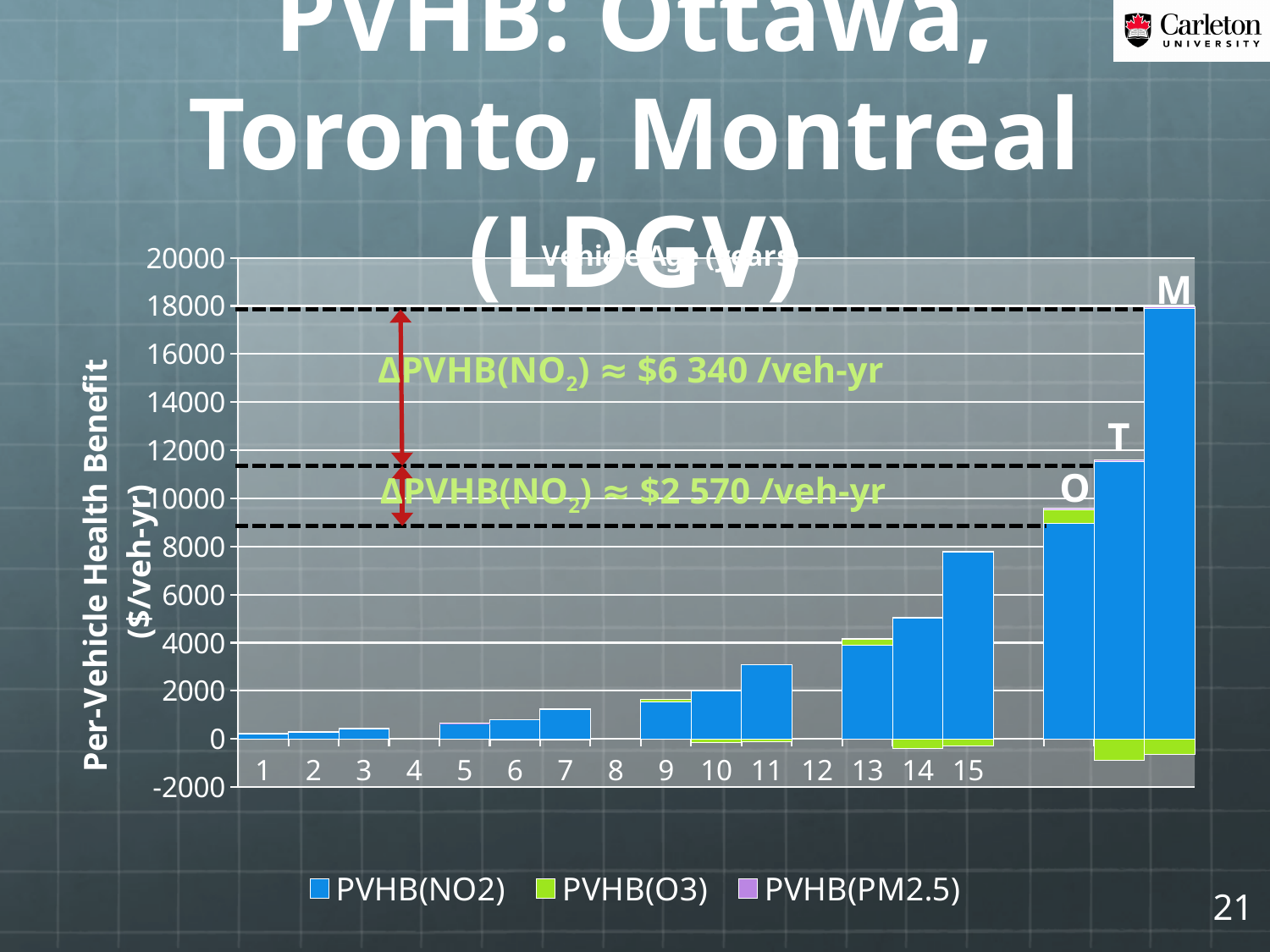
What kind of chart is shown on the slide? Stacked bar chart Do the PVHB(NO2) values generally rise or fall as vehicle age increases from 1 to 15? rise Is the PVHB(NO2) value for vehicle age 9 greater or less than 2000? less Which of the city bars (O, T, M) is the highest? M Which has the larger PVHB(NO2) value, bar T or bar O? T Is the PVHB(NO2) value for bar T greater or less than 10000? greater How many numbered vehicle-age categories are labeled on the x axis? 15 What is the label of the vertical axis? Per-Vehicle Health Benefit ($/veh-yr) Is the PVHB(NO2) value for bar M greater or less than 16000? greater Which of the city bars (O, T, M) is the lowest? O How many series does the legend list? 3 Which series is shown in blue in the legend? PVHB(NO2)